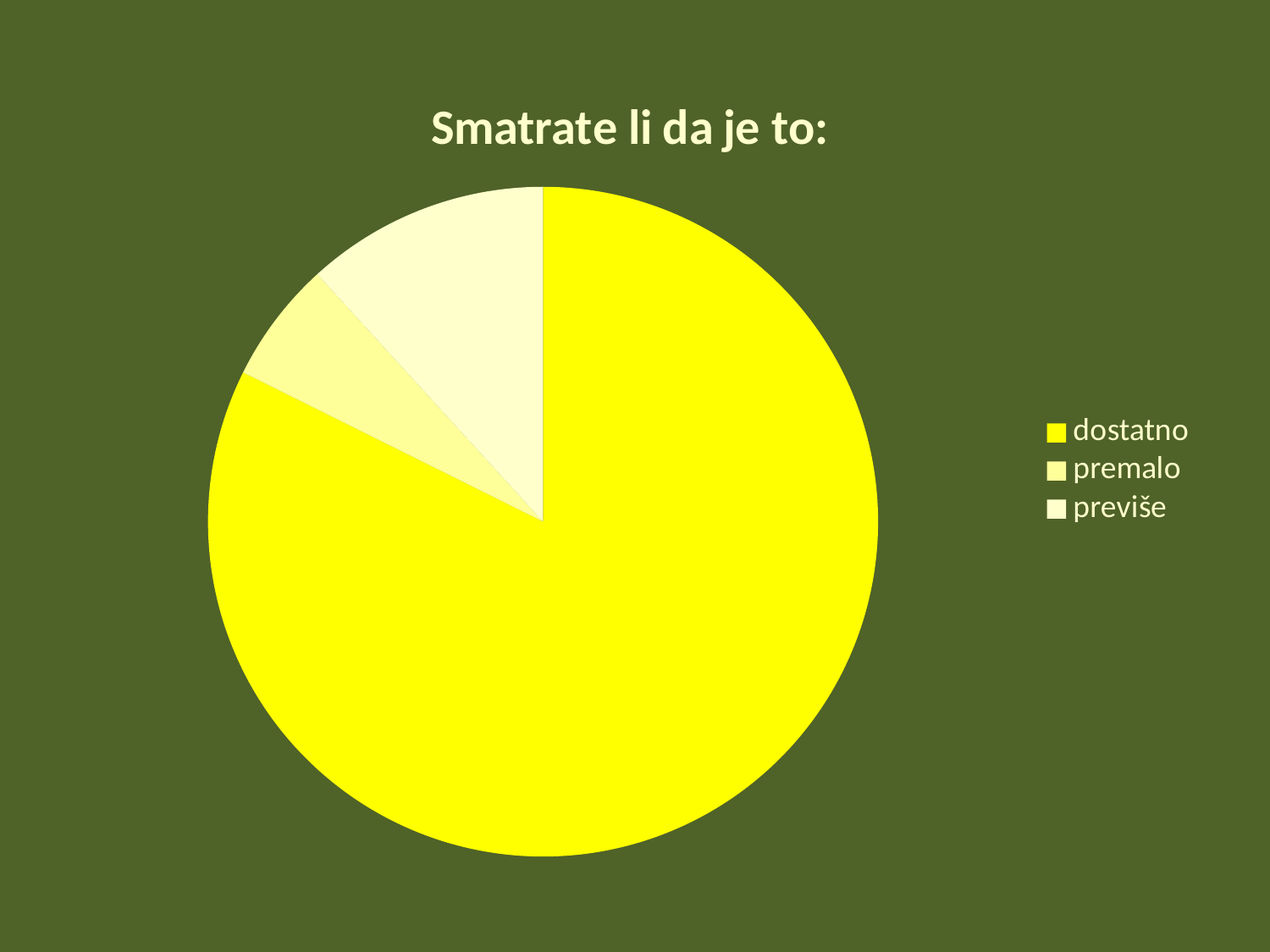
Which slice is larger, previše or premalo? previše What kind of chart is shown on the slide? pie chart How many slices does the pie chart have? 3 What is the title of the chart? Smatrate li da je to: Which category has the smallest slice of the pie? premalo Which category has the largest slice of the pie? dostatno Which slice is larger, dostatno or previše? dostatno How many entries does the legend list? 3 Which legend entry is listed first? dostatno